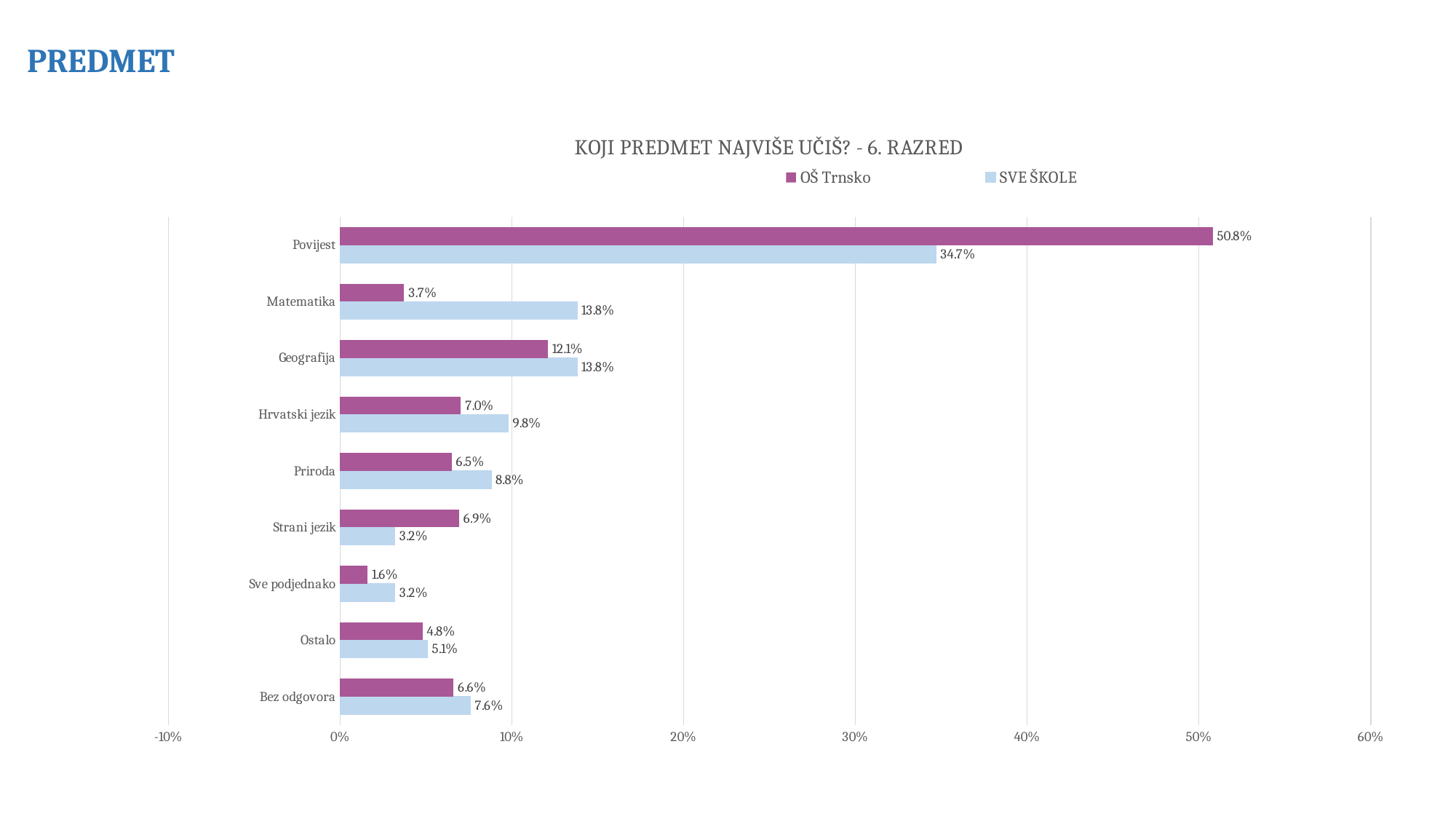
Which category has the lowest OŠ Trnsko value? Sve podjednako What is the OŠ Trnsko value for Strani jezik? 6.9% Is the SVE ŠKOLE value for Povijest greater or less than 30%? greater How many categories are shown on the chart? 9 What kind of chart is shown on the slide? bar chart Which category has the highest SVE ŠKOLE value? Povijest What is the difference between the OŠ Trnsko and SVE ŠKOLE values for Povijest? 16.1% Which is larger for Matematika: the OŠ Trnsko value or the SVE ŠKOLE value? SVE ŠKOLE How many series does the legend list? 2 What is the OŠ Trnsko value for Povijest? 50.8% What is the SVE ŠKOLE value for Matematika? 13.8% What is the title of the chart? KOJI PREDMET NAJVIŠE UČIŠ? - 6. RAZRED